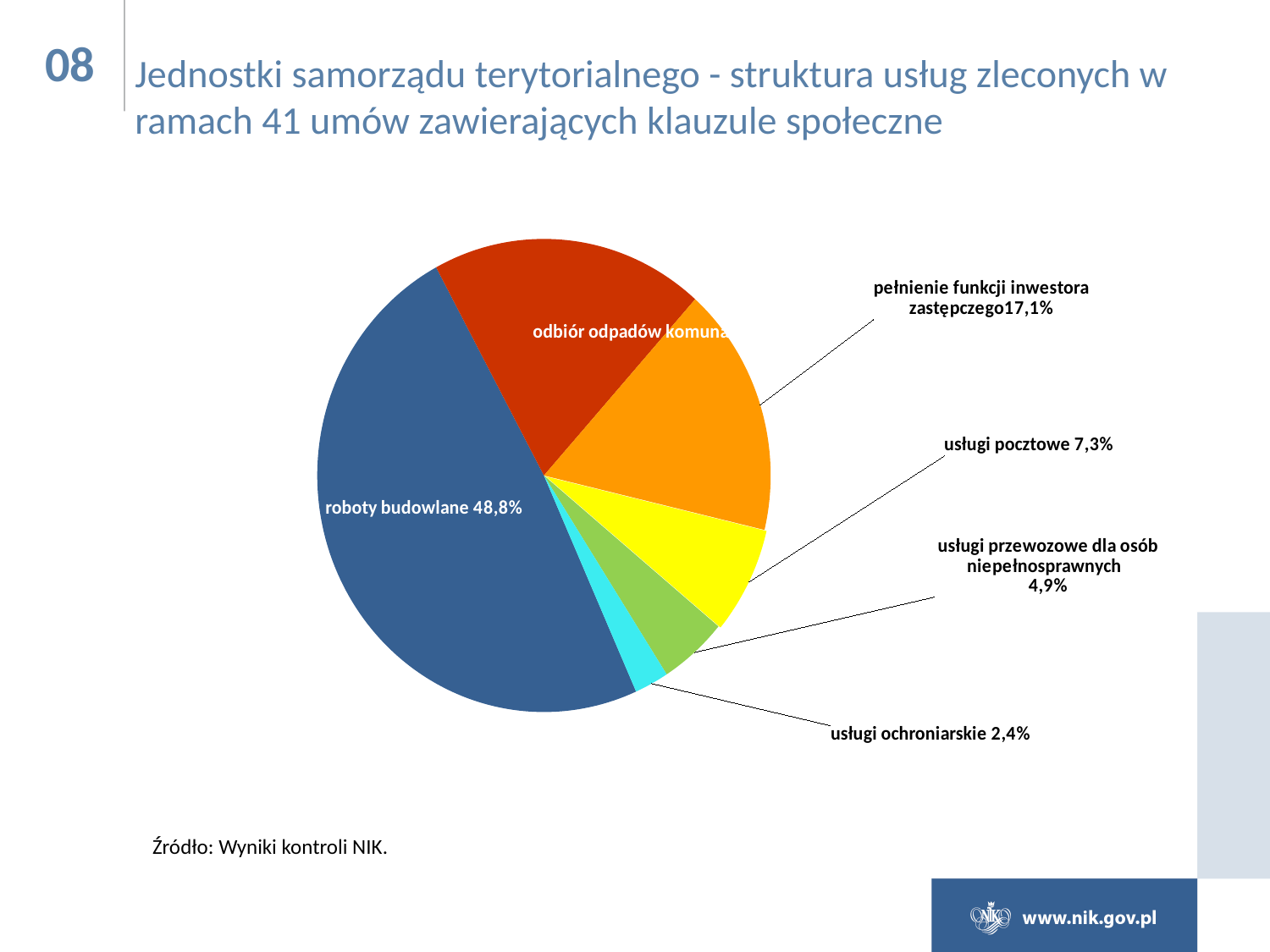
What share is shown for "usługi ochroniarskie"? 2,4% Which category has the largest slice of the pie? roboty budowlane What share is shown for "pełnienie funkcji inwestora zastępczego"? 17,1% What source is cited below the chart? Wyniki kontroli NIK. Which category has the smallest slice of the pie? usługi ochroniarskie Which is larger: the share for "usługi pocztowe" or for "usługi przewozowe dla osób niepełnosprawnych"? usługi pocztowe What kind of chart is shown on the slide? pie chart What share of the pie does "roboty budowlane" represent? 48,8% What share is shown for "usługi pocztowe"? 7,3% What share is shown for "usługi przewozowe dla osób niepełnosprawnych"? 4,9% What is the difference in percentage points between "roboty budowlane" and "pełnienie funkcji inwestora zastępczego"? 31,7 How many slices does the pie chart have? 6